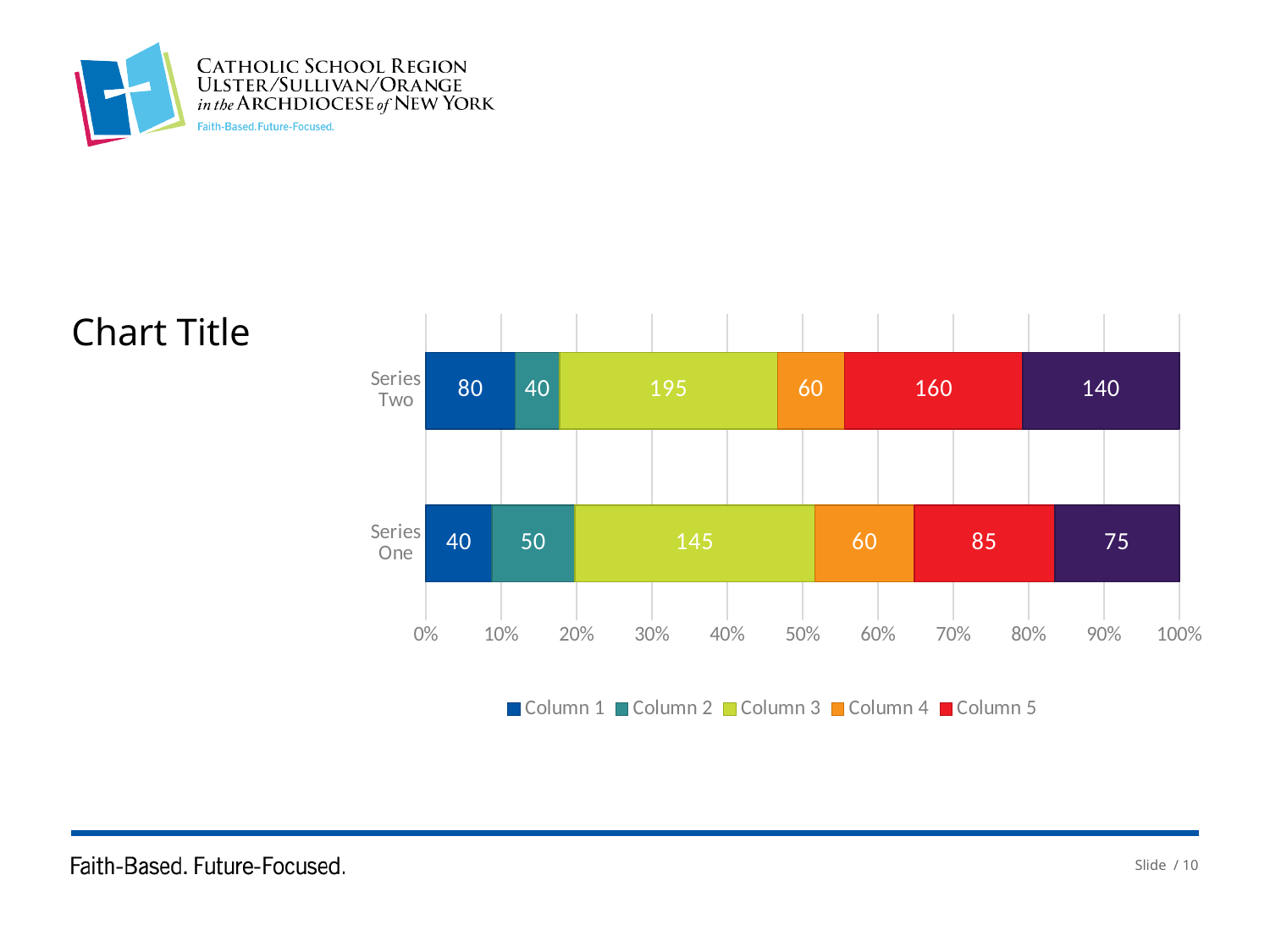
Which has the larger Column 1 value, Series One or Series Two? Series Two What is the value of Column 3 for Series Two? 195 What type of chart is shown on the slide? Stacked bar chart Which has the larger Column 2 value, Series One or Series Two? Series One What is the value of Column 5 for Series Two? 160 What is the difference between the Column 3 values for Series Two and Series One? 50 What is the value of Column 1 for Series One? 40 How many series does the legend list? 5 What is the difference between the Column 5 values for Series Two and Series One? 75 How many bars (categories) are shown in the chart? 2 Which column has the largest value in the Series One bar? Column 3 What is the value of Column 4 for Series One? 60